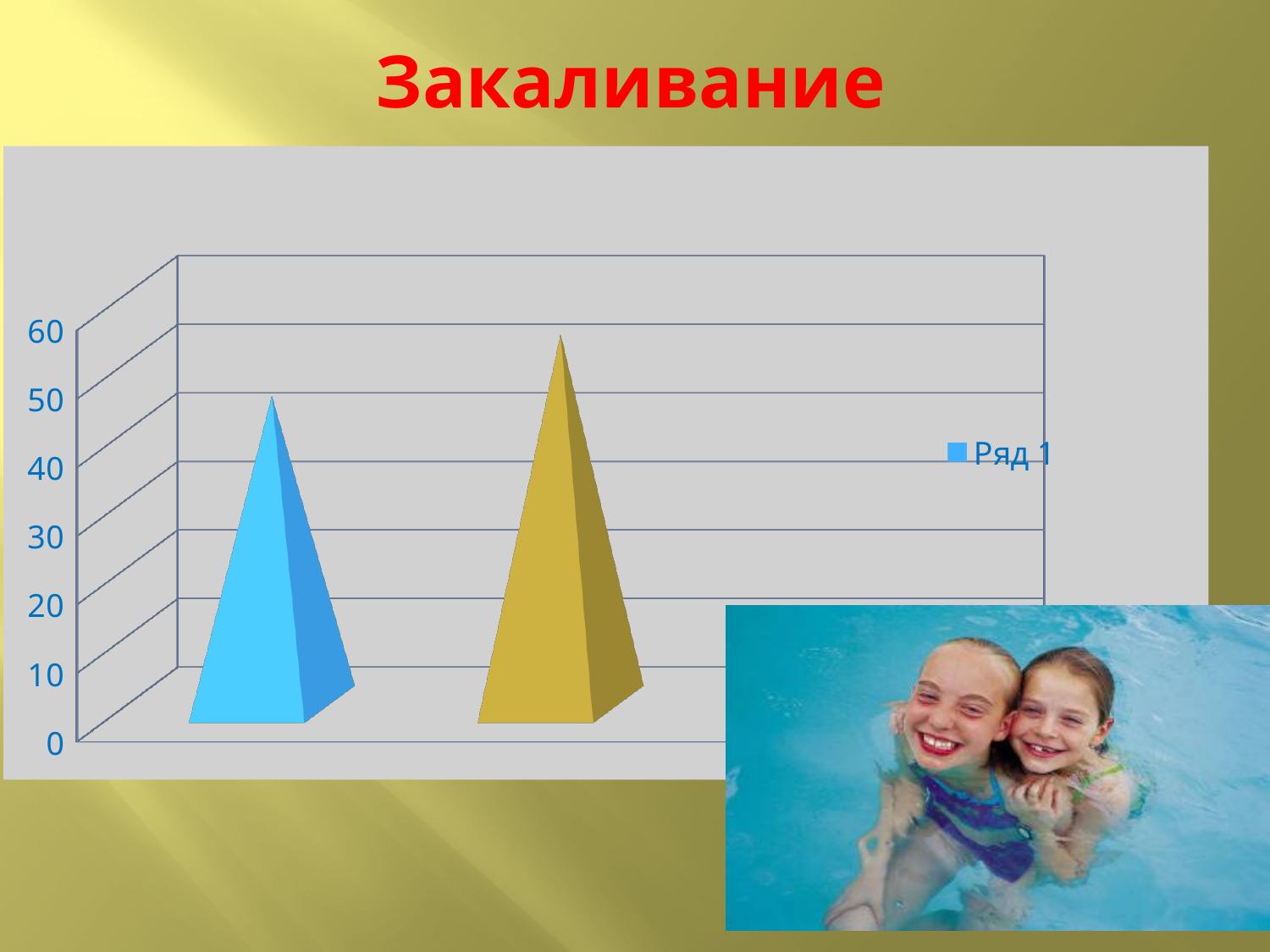
Which bar is taller, the blue one on the left or the gold one on the right? the gold one on the right How many series does the chart legend list? 1 What kind of chart is shown on the slide? bar chart Which bar has the highest value in the chart? the gold bar on the right Is the value of the blue bar on the left greater or less than 30? greater What is the title of the slide above the chart? Закаливание What is the legend entry shown in the chart? Ряд 1 Is the value of the blue bar on the left greater or less than 60? less Is the value of the gold bar on the right greater or less than 40? greater